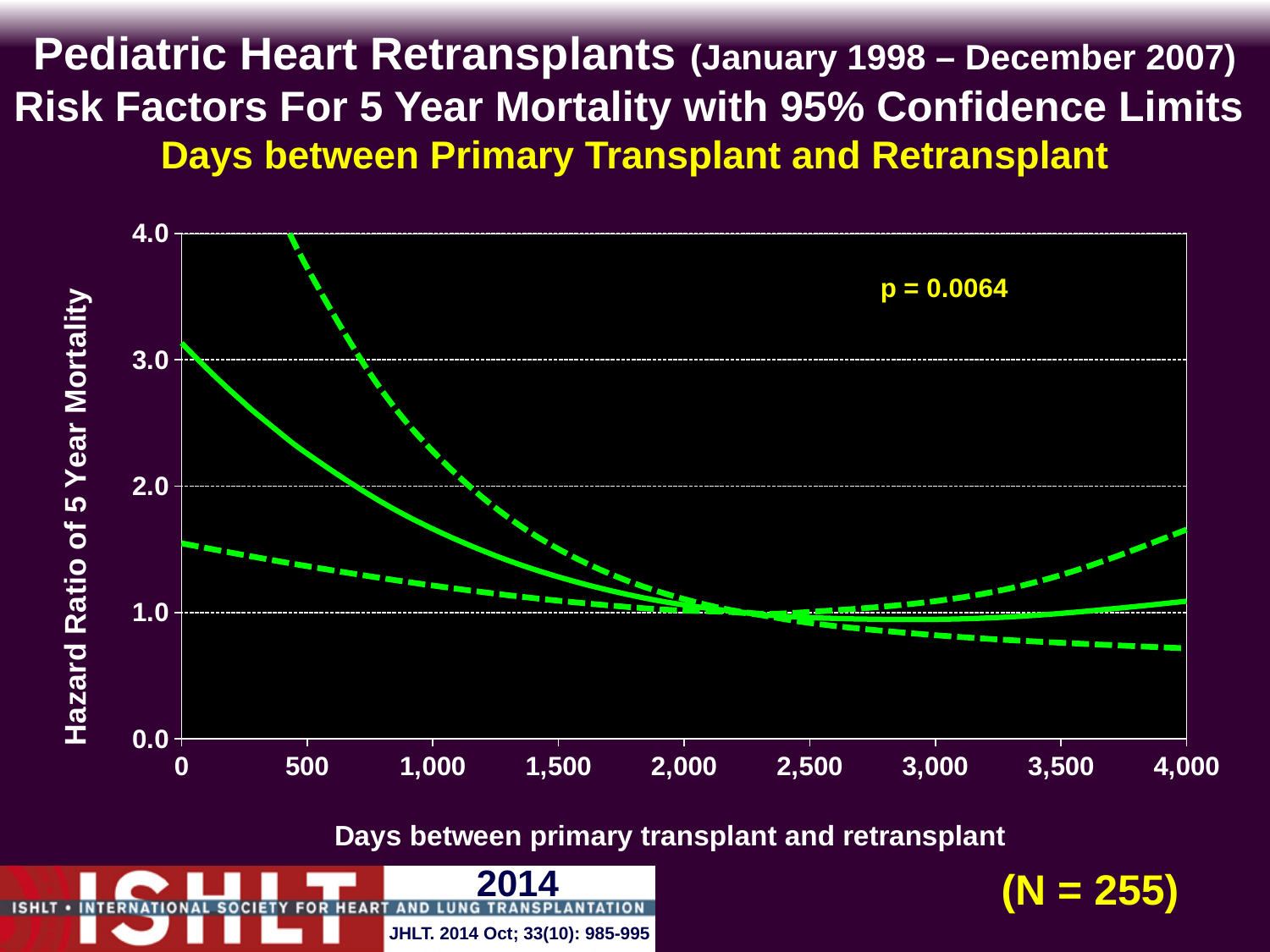
Is the upper dashed confidence limit at 1,000 days greater or less than 2.0? greater Is the lower dashed confidence limit at 0 days greater or less than 2.0? less Is the lower dashed confidence limit at 4,000 days greater or less than 1.0? less Is the solid hazard ratio line higher at 500 days or at 3,000 days? 500 days What p value is printed on the chart? p = 0.0064 How many lines are plotted on the chart? 3 What sample size (N) is shown on the slide? N = 255 How many tick labels are shown on the x axis? 9 What kind of chart is shown on the slide? line chart Does the solid hazard ratio line rise or fall as days between primary transplant and retransplant increase from 0 to 2,000? fall